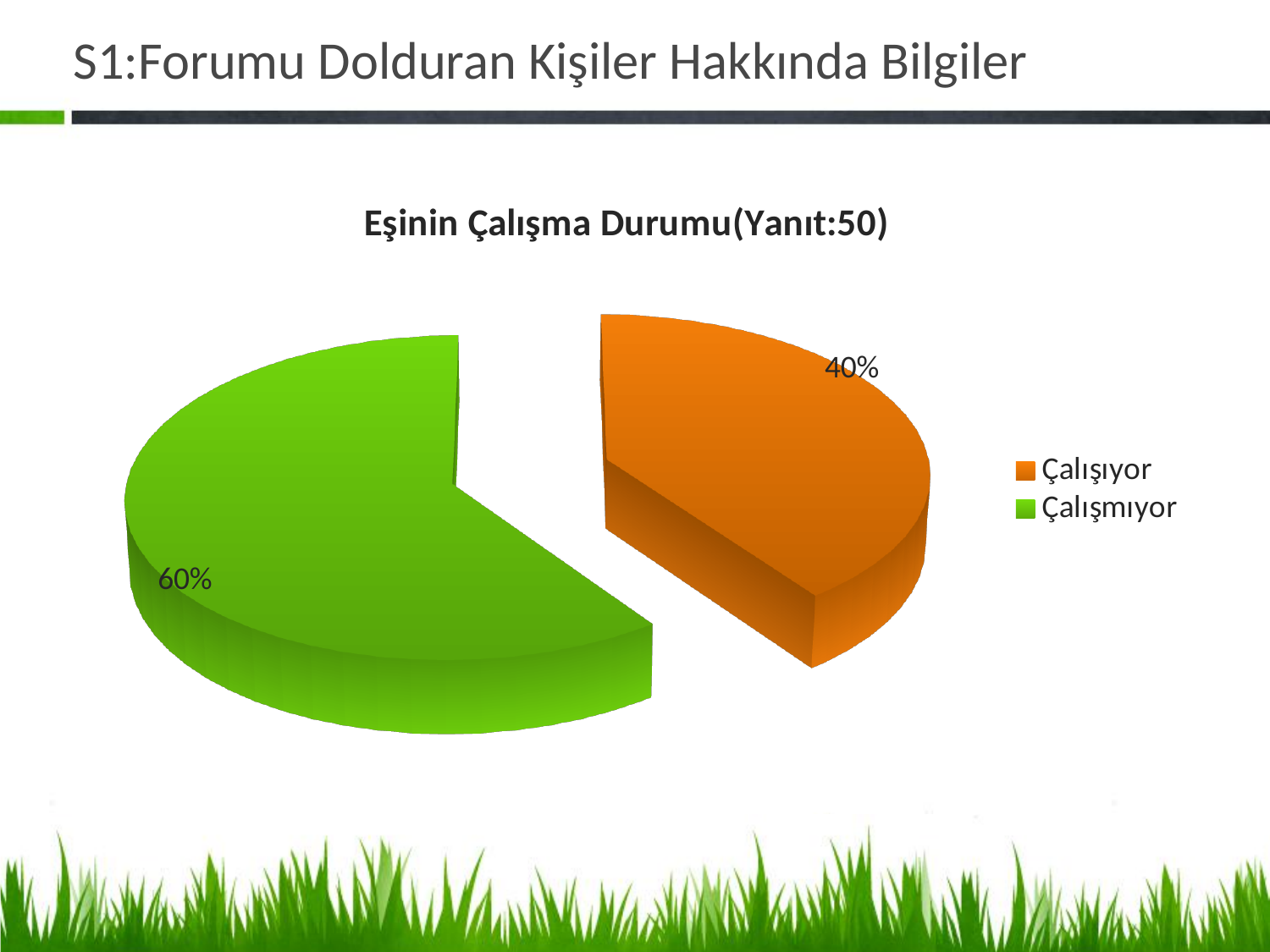
What percentage of the pie chart is labelled Çalışmıyor? 60% What is the title of the chart? Eşinin Çalışma Durumu(Yanıt:50) What share of the pie does the green slice represent? 60% Which slice is larger, Çalışıyor or Çalışmıyor? Çalışmıyor How many entries does the legend list? 2 What colour is the Çalışıyor slice? Orange What percentage of the pie chart is labelled Çalışıyor? 40% Which category has the smallest share of the pie chart? Çalışıyor What kind of chart is shown on the slide? Pie chart How many slices does the pie chart have? 2 Which category has the largest share of the pie chart? Çalışmıyor What is the difference in percentage points between the Çalışmıyor and Çalışıyor slices? 20